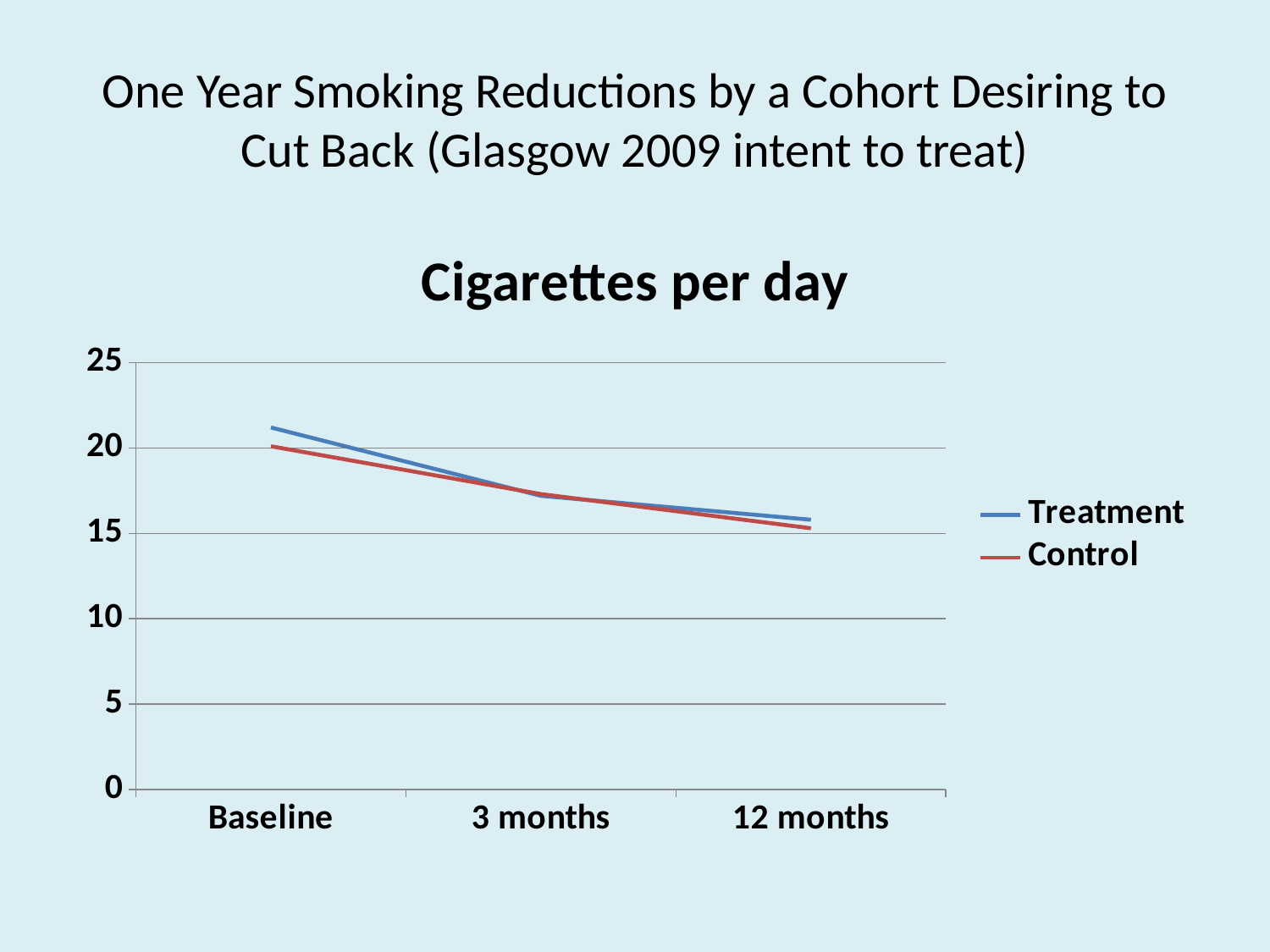
What is the title of the chart? Cigarettes per day Is the Treatment value at 3 months greater or less than 20? less Which series is drawn in red? Control What kind of chart is shown on the slide? line chart At Baseline, which series has the higher value, Treatment or Control? Treatment Do the Treatment values rise or fall from Baseline to 12 months? fall Is the Treatment value at Baseline greater or less than 20? greater How many series does the legend list? 2 How many time points are plotted along the x axis? 3 Do the Control values rise or fall from Baseline to 12 months? fall At which time point is the Treatment series highest? Baseline At which time point is the Control series lowest? 12 months